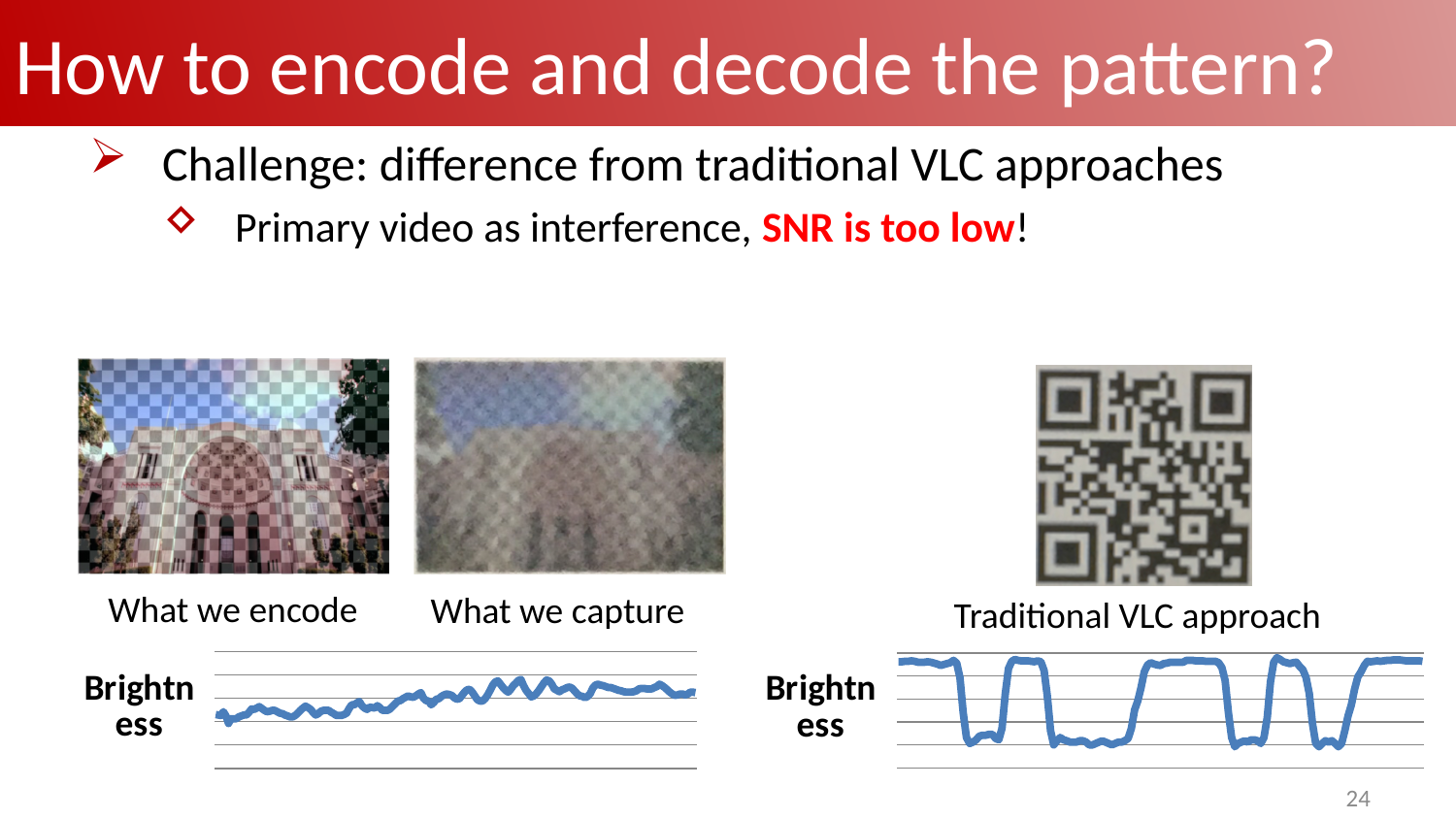
What is the y-axis label of the chart at the bottom left of the slide? Brightness How many lines are plotted in the chart at the bottom right of the slide? 1 What kind of chart is the chart at the bottom right of the slide, below "Traditional VLC approach"? line chart In the chart at the bottom left of the slide, does the line generally rise or fall from left to right? rise What is the y-axis label of the chart at the bottom right of the slide? Brightness What kind of chart is the chart at the bottom left of the slide, below "What we encode" and "What we capture"? line chart How many lines are plotted in the chart at the bottom left of the slide? 1